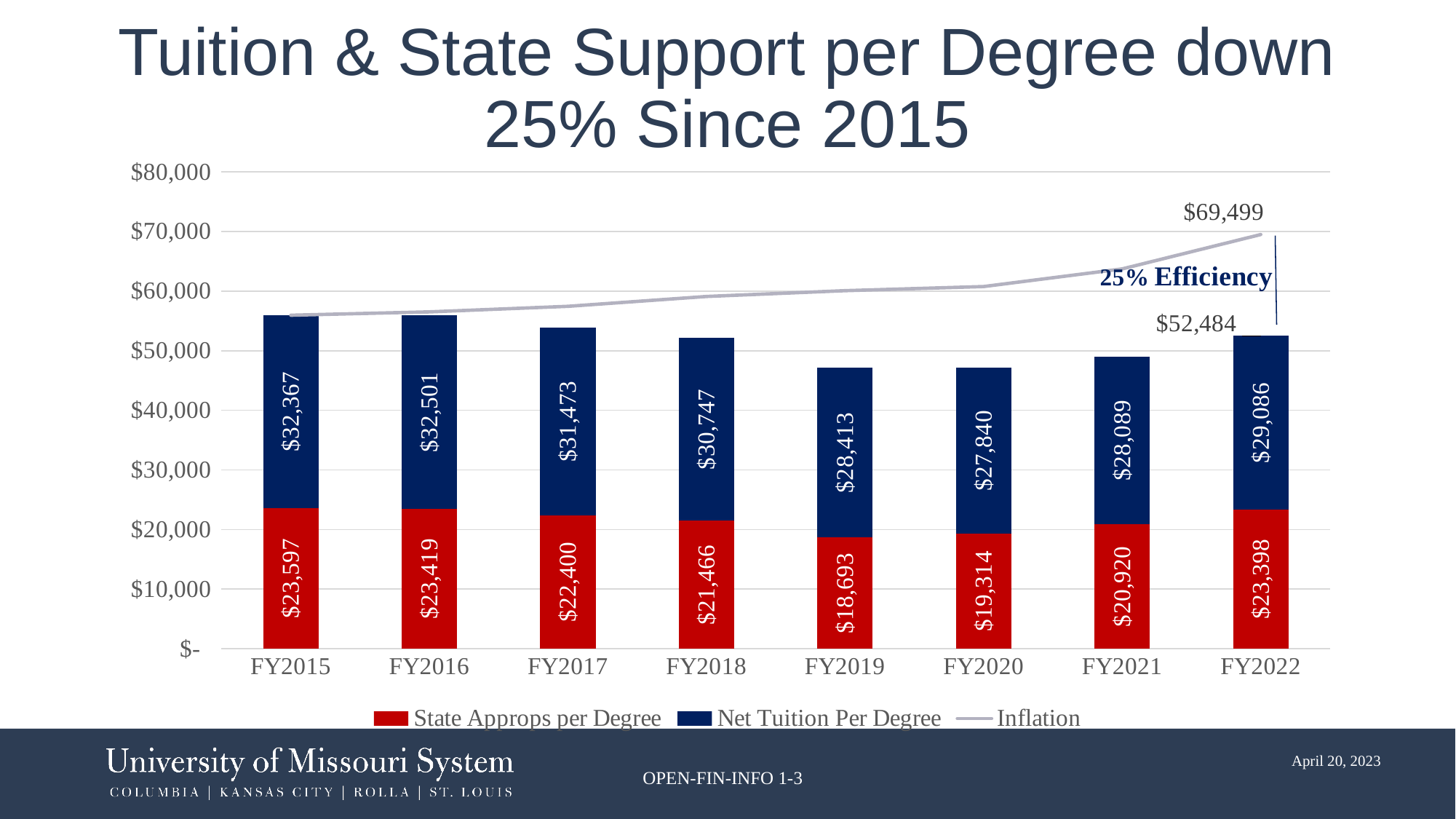
Which is larger, Net Tuition Per Degree in FY2017 or in FY2021? FY2017 Which fiscal year has the highest Net Tuition Per Degree? FY2016 What is the difference between State Approps per Degree in FY2015 and FY2019? $4,904 Is the total height of the FY2019 stacked bar greater or less than $50,000? less How many fiscal years are shown on the x axis? 8 What is the value of Net Tuition Per Degree for FY2022? $29,086 What is the value of State Approps per Degree for FY2019? $18,693 Which fiscal year has the lowest State Approps per Degree? FY2019 What is the Inflation value shown for FY2022? $69,499 How many series does the legend list? 3 What is the total of the FY2015 stacked bar (State Approps plus Net Tuition)? $55,964 What kind of chart is shown on the slide? Stacked bar chart with a line